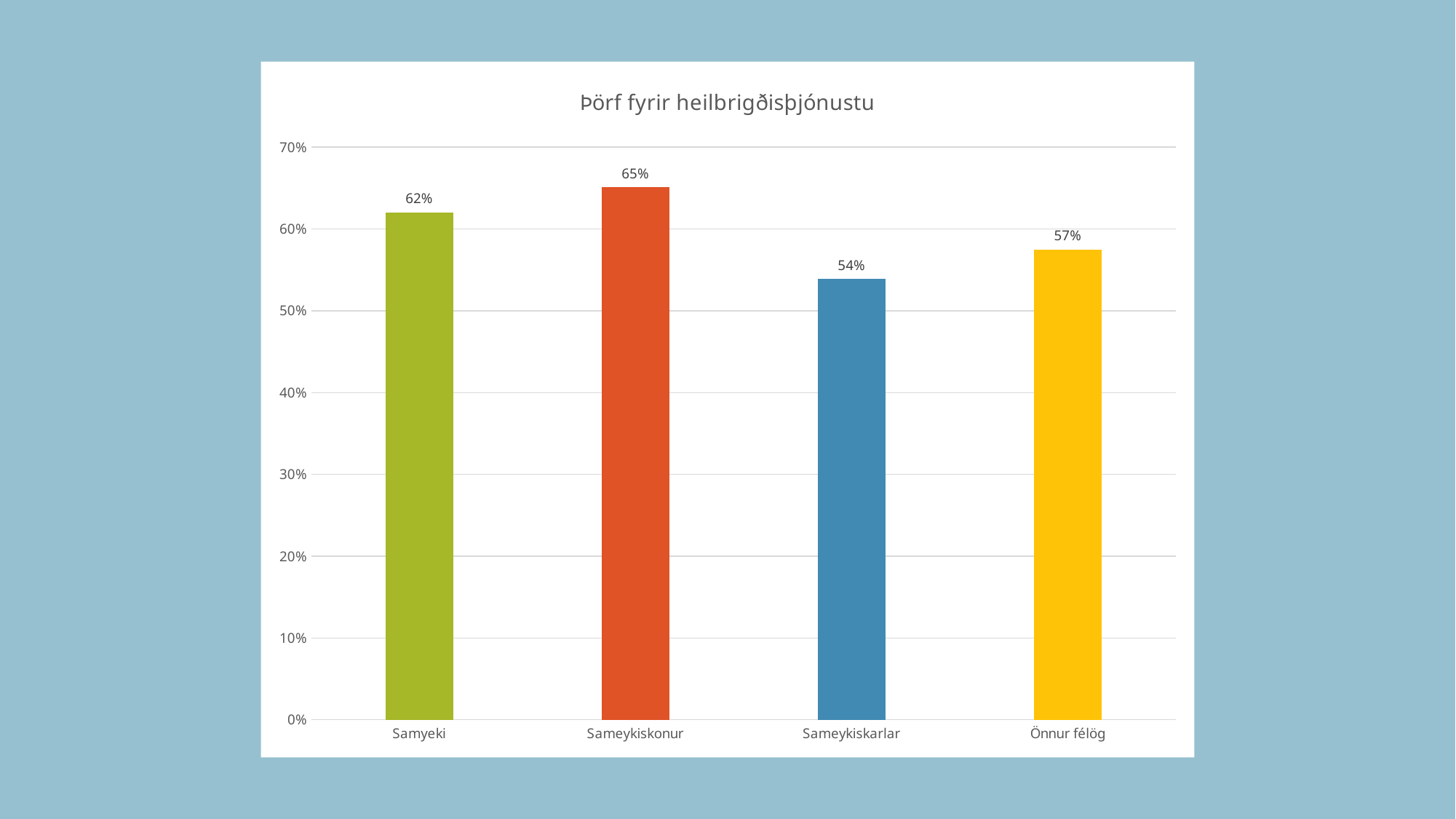
Which is larger, the value for Samyeki or the value for Önnur félög? Samyeki Is the value for Sameykiskarlar greater or less than 60%? less Which category has the highest value? Sameykiskonur What is the value for Sameykiskonur? 65% What is the title of the chart? Þörf fyrir heilbrigðisþjónustu What is the value for Sameykiskarlar? 54% What is the difference between the values for Sameykiskonur and Sameykiskarlar? 11% How many categories are shown on the x axis? 4 What is the value for Samyeki? 62% What kind of chart is shown on the slide? bar chart Which category has the lowest value? Sameykiskarlar What is the value for Önnur félög? 57%